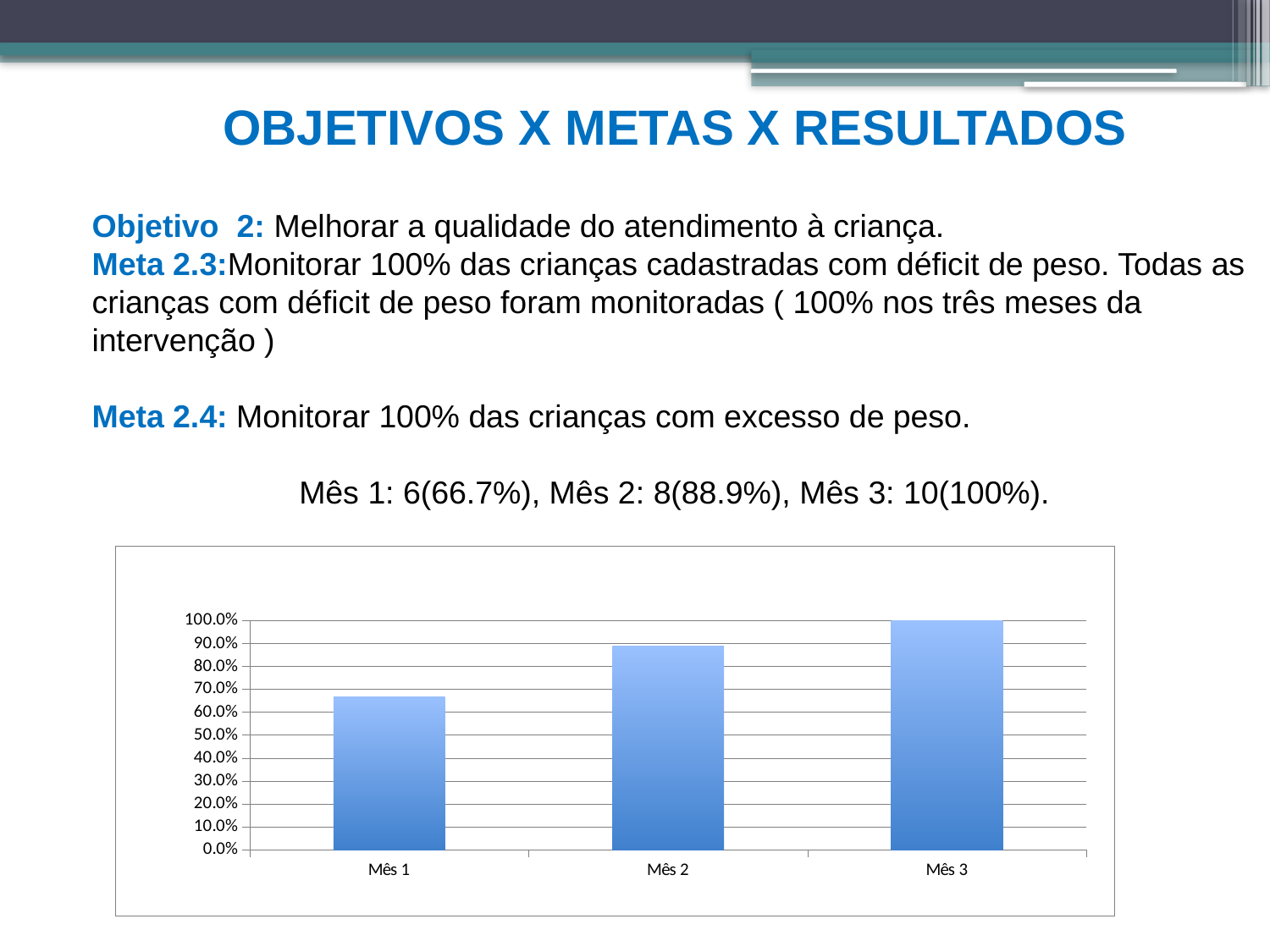
Which month has the lowest bar in the chart? Mês 1 Which is larger, the value for Mês 1 or the value for Mês 2? Mês 2 What is the highest tick value shown on the vertical axis of the chart? 100.0% How many categories (months) are plotted in the chart? 3 Is the value for Mês 1 greater or less than 60.0%? greater What is the percentage value for Mês 2? 88.9% What kind of chart is shown on the slide? bar chart What is the difference between the values for Mês 3 and Mês 1? 33.3% Which month has the highest bar in the chart? Mês 3 What is the percentage value for Mês 1? 66.7% What is the percentage value for Mês 3? 100% Do the values rise or fall from Mês 1 to Mês 3? rise